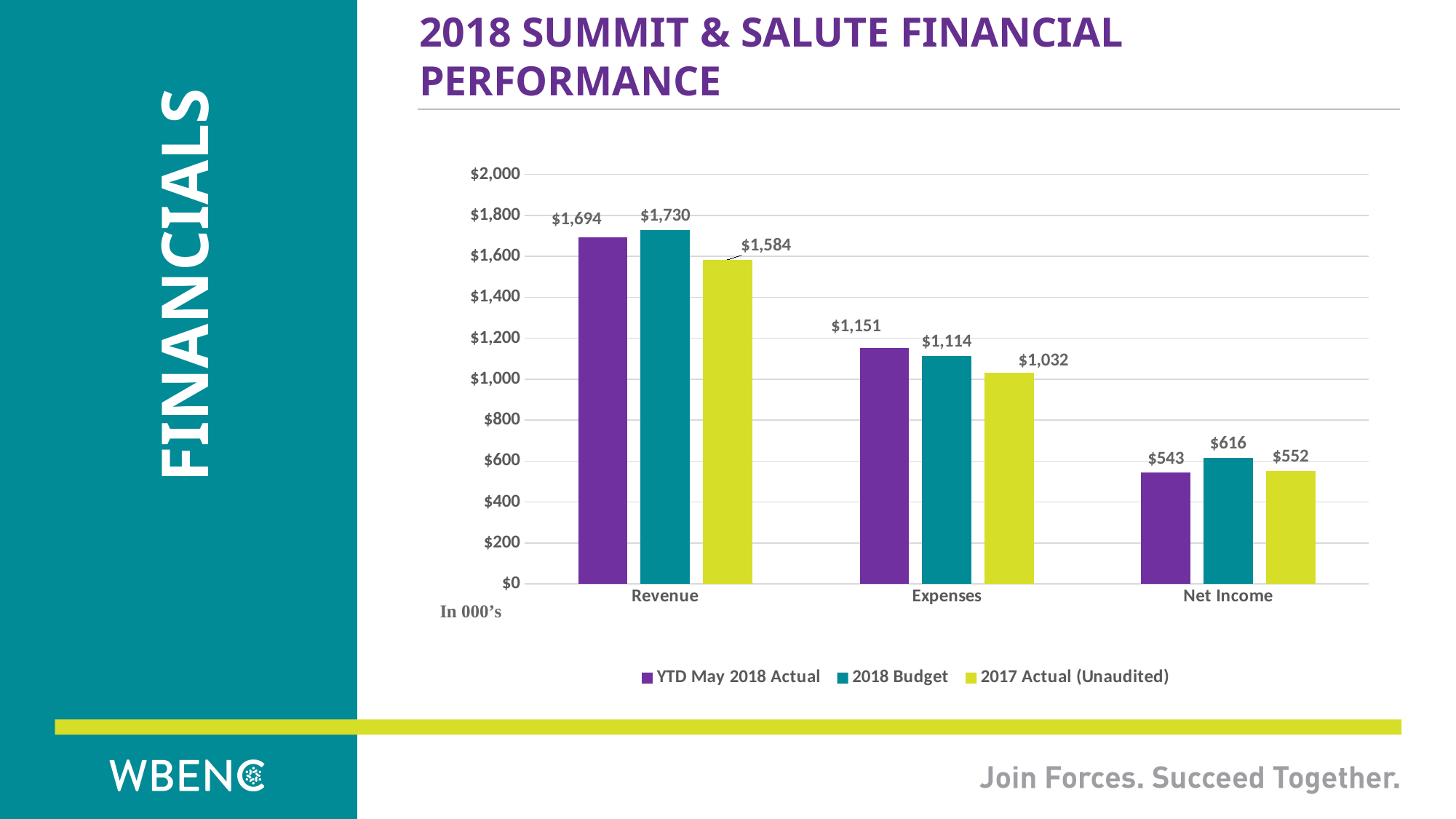
Which is larger for Net Income: the 2018 Budget value or the 2017 Actual (Unaudited) value? 2018 Budget What is the YTD May 2018 Actual value for Revenue? $1,694 What is the title of the chart on the slide? 2018 Summit & Salute Financial Performance Which category has the highest 2018 Budget value? Revenue How many series does the legend list? 3 What is the 2018 Budget value for Expenses? $1,114 What is the 2017 Actual (Unaudited) value for Net Income? $552 Is the 2017 Actual (Unaudited) value for Expenses greater or less than $1,200? less Which category has the lowest YTD May 2018 Actual value? Net Income What kind of chart is shown on the slide? Bar chart What is the difference between the 2018 Budget and YTD May 2018 Actual values for Revenue? $36 How many categories are shown on the x axis? 3